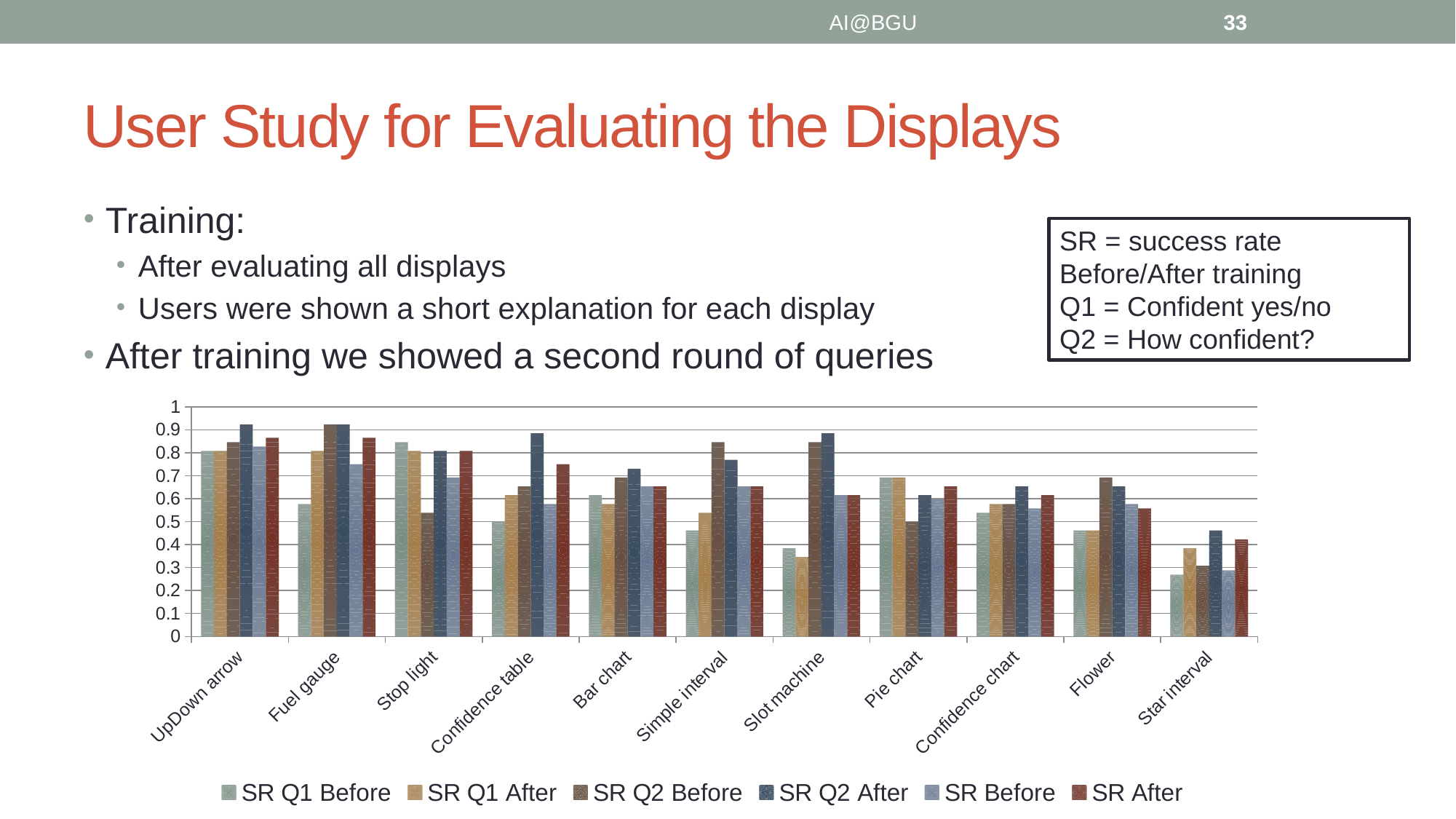
Is the SR After value for Star interval greater or less than 0.5? less Is the SR Q2 After value for UpDown arrow greater or less than 0.8? greater Is the SR Q1 Before value for Slot machine greater or less than 0.5? less How many series does the chart's legend list? 6 How many display categories are shown along the x axis of the chart? 11 Which display category has the lowest SR After value? Star interval Which series is shown in the last (rightmost) legend entry? SR After What kind of chart is shown on the slide? bar chart For Star interval, which is larger: SR Q1 Before or SR Q1 After? SR Q1 After For Slot machine, which is larger: SR Q1 Before or SR Q2 After? SR Q2 After